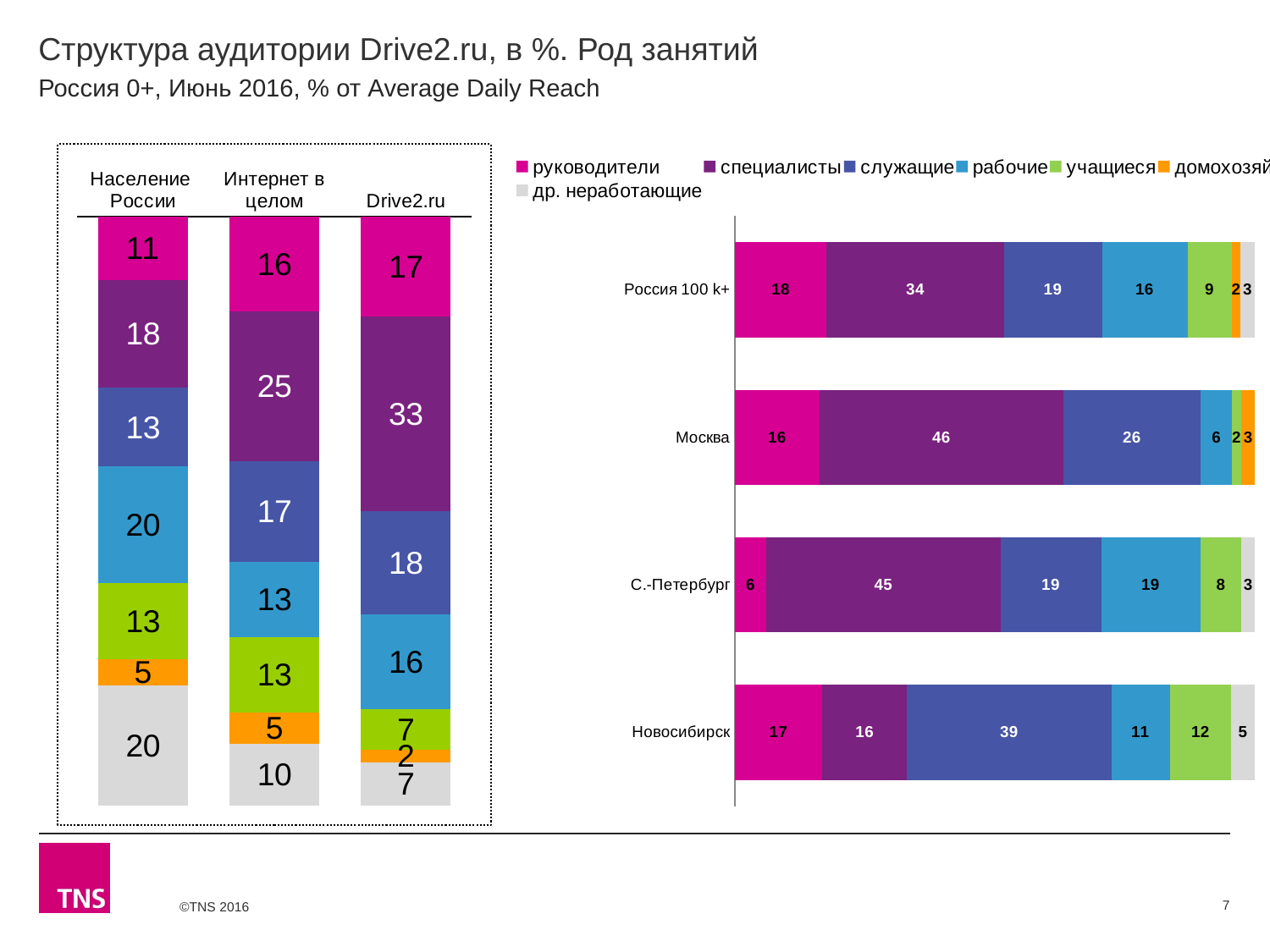
What kind of chart is the right chart? bar chart In the left chart, what is the value for рабочие in the Население России bar? 20 In the left chart, what is the difference between the специалисты values for Drive2.ru and Население России? 15 In the right chart, how many regions are shown? 4 In the left chart, which segment is the largest in the Drive2.ru bar? специалисты In the left chart, how many bars are shown? 3 In the left chart, which has a larger руководители value: Drive2.ru or Население России? Drive2.ru In the right chart, which region has the highest специалисты value? Москва In the left chart, what is the value for специалисты in the Drive2.ru bar? 33 In the right chart, what is the value for служащие for Новосибирск? 39 In the right chart, what is the value for специалисты for Москва? 46 In the right chart, what is the value for руководители for С.-Петербург? 6